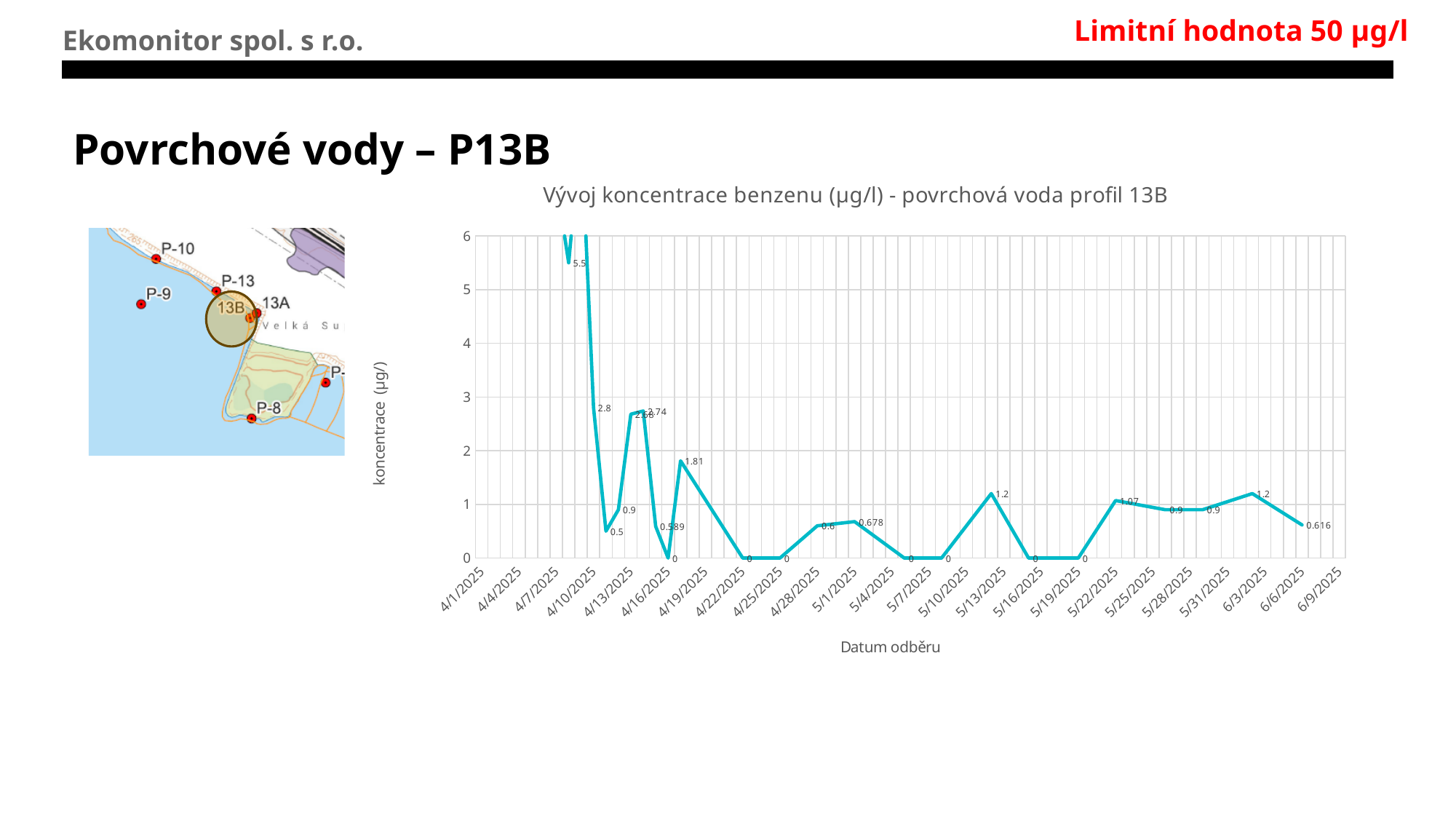
Is the data point labelled 5.5 greater or less than 5? greater What is the difference between the data points labelled 2.8 and 0.5? 2.3 Is the value of the last data point on the chart greater or less than 1? less How many lines (data series) are plotted on the chart? 1 What kind of chart is shown on the slide? line chart What is the value of the last data point on the chart (at the right end of the line)? 0.616 What is the label of the x axis of the chart? Datum odběru What is the title of the chart? Vývoj koncentrace benzenu (µg/l) - povrchová voda profil 13B Which is larger, the data point labelled 1.81 or the one labelled 2.74? 2.74 What is the highest tick value shown on the y axis? 6 Overall, do the values rise or fall from the left of the chart to the right? fall What is the lowest value plotted on the chart? 0